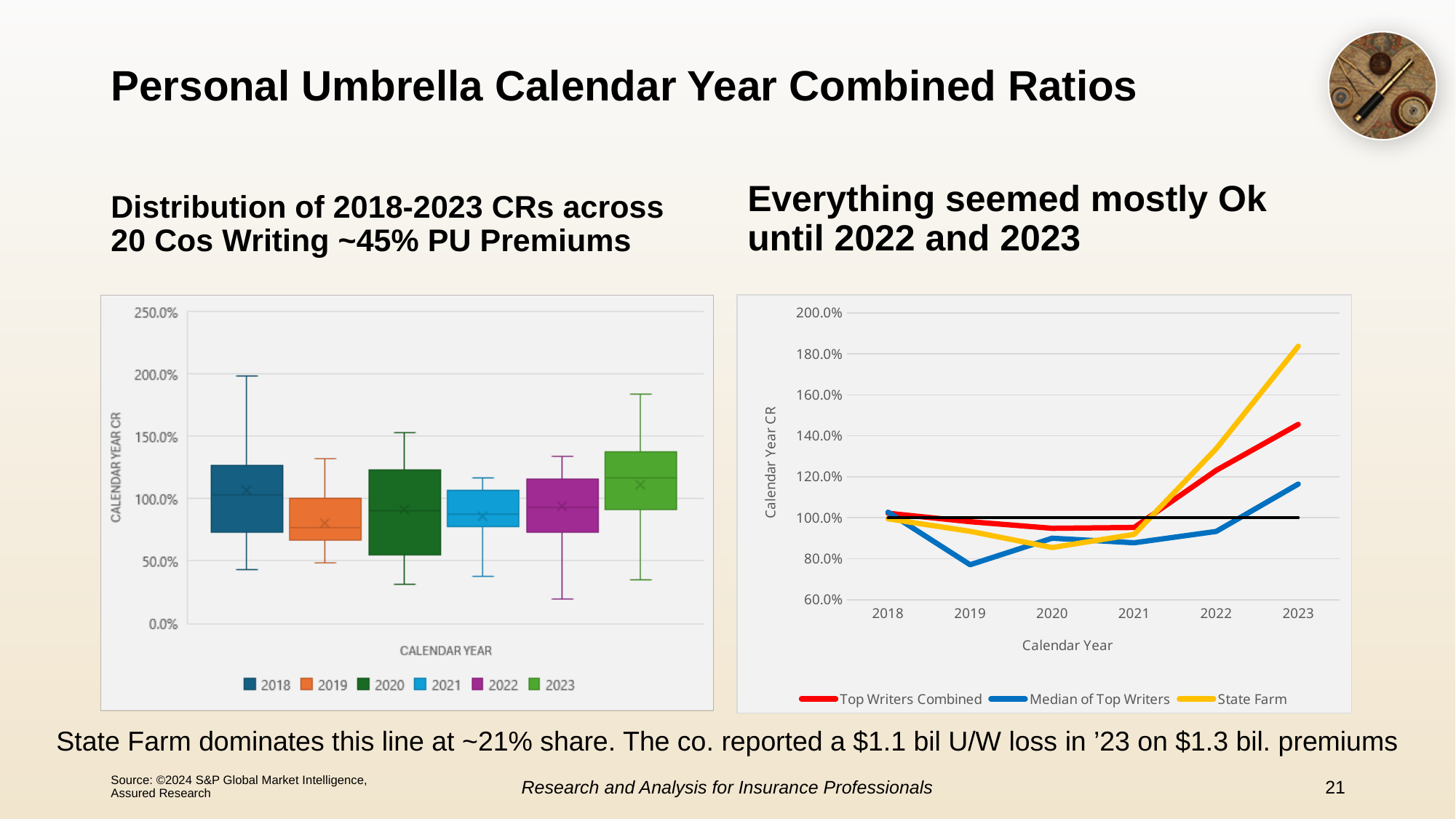
In the right-hand chart, which series has the highest value in 2023? State Farm In the left-hand box plot chart, which calendar year has the highest upper whisker? 2018 In the right-hand chart, in which year is the Median of Top Writers line at its lowest? 2019 What colour is the State Farm line in the right-hand chart? yellow In the right-hand chart, do the Top Writers Combined values rise or fall from 2021 to 2023? rise How many calendar years are plotted on the x axis of the right-hand chart? 6 In the right-hand chart, which is larger in 2022: Top Writers Combined or Median of Top Writers? Top Writers Combined In the right-hand chart, is the Median of Top Writers value for 2019 greater or less than 80.0%? less How many series does the legend of the right-hand chart list? 3 In the right-hand chart, is the State Farm value for 2023 greater or less than 160.0%? greater How many calendar years does the legend of the left-hand box plot chart list? 6 What kind of chart is the chart on the right of the slide? line chart